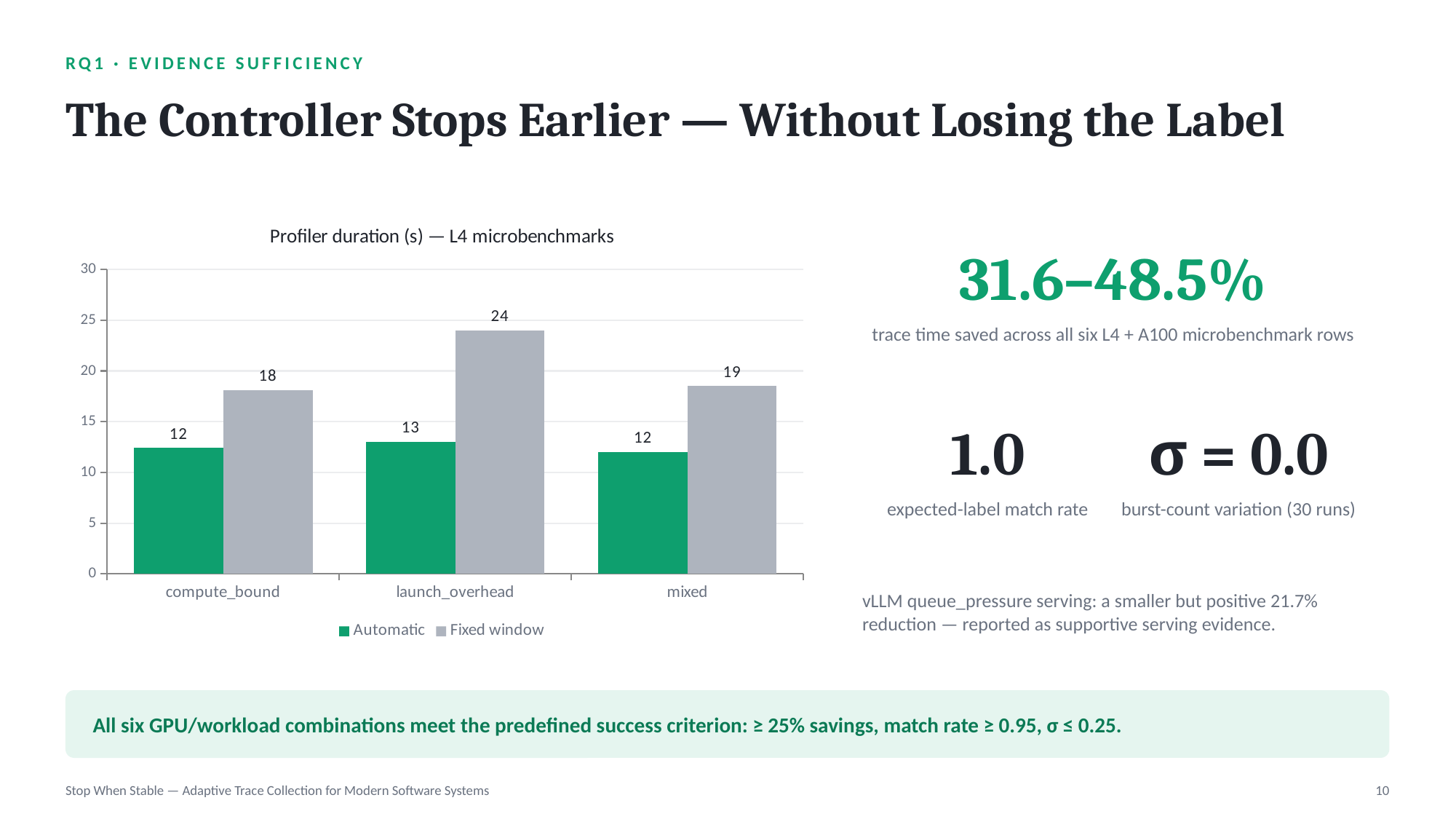
How many series does the legend list? 2 What is the Automatic value for compute_bound? 12 Which is larger for mixed: the Automatic value or the Fixed window value? Fixed window What is the Fixed window value for launch_overhead? 24 Which category has the highest Fixed window value? launch_overhead Is the Fixed window value for launch_overhead greater or less than 20? greater What type of chart is shown on the slide? bar chart What is the Fixed window value for mixed? 19 Which category has the lowest Fixed window value? compute_bound What is the difference between the Fixed window and Automatic values for launch_overhead? 11 What is the difference between the Fixed window and Automatic values for compute_bound? 6 How many categories are shown on the x axis? 3